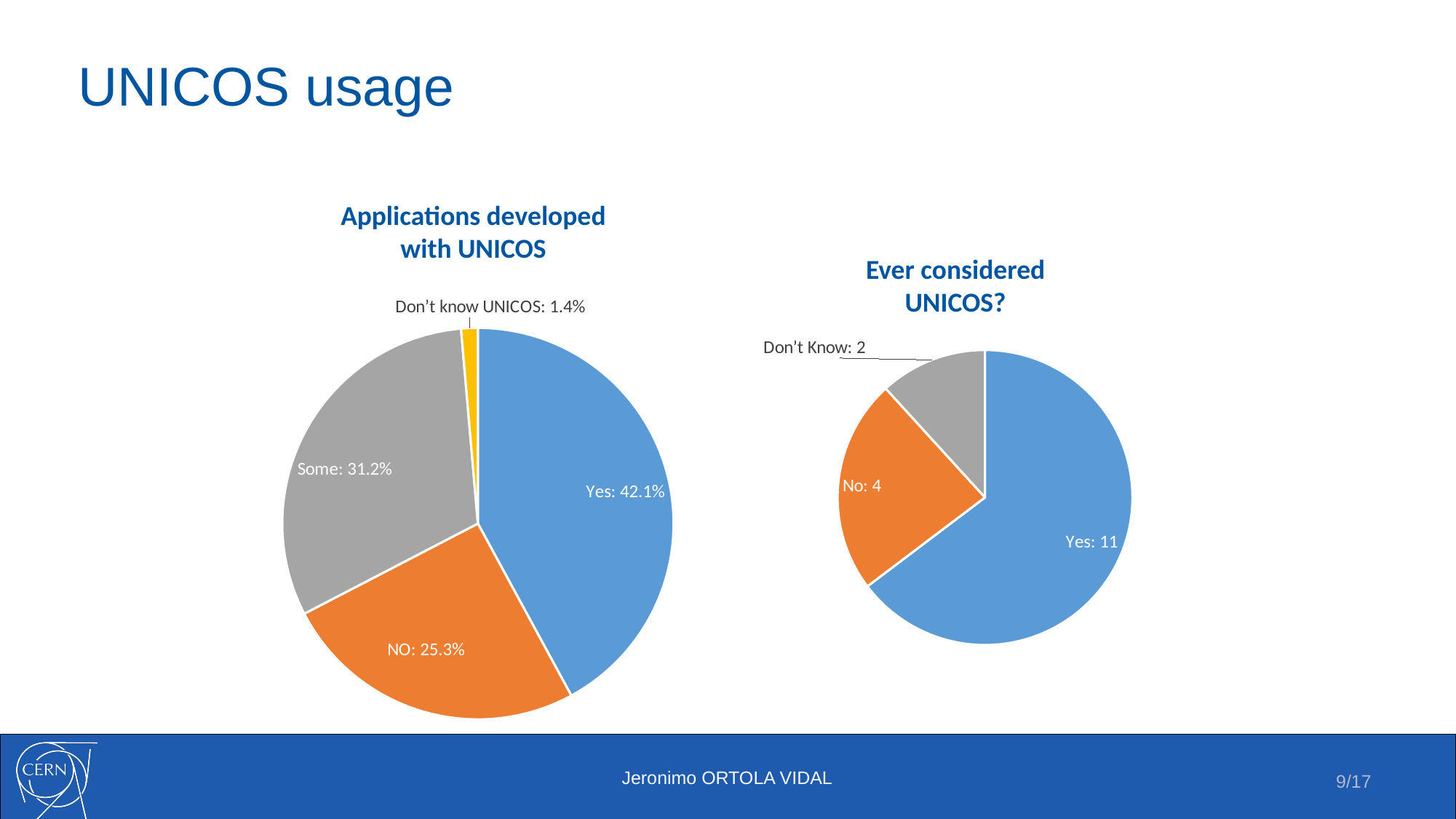
In the 'Ever considered UNICOS?' chart, which category has the largest slice? Yes In the 'Applications developed with UNICOS' chart, how many slices does the pie have? 4 In the 'Applications developed with UNICOS' chart, what is the difference between the 'Yes' and 'NO' percentages? 16.8% In the 'Ever considered UNICOS?' chart, what is the total of all slices? 17 In the 'Applications developed with UNICOS' chart, what percentage is labelled 'Yes'? 42.1% What kind of chart is used for 'Ever considered UNICOS?'? pie chart In the 'Applications developed with UNICOS' chart, which category has the largest slice? Yes In the 'Ever considered UNICOS?' chart, what is the value for 'Don't Know'? 2 In the 'Applications developed with UNICOS' chart, what percentage is labelled 'Some'? 31.2% In the 'Ever considered UNICOS?' chart, is the 'No' slice larger or smaller than the 'Don't Know' slice? larger In the 'Ever considered UNICOS?' chart, what is the value for 'No'? 4 In the 'Applications developed with UNICOS' chart, which category has the smallest slice? Don't know UNICOS